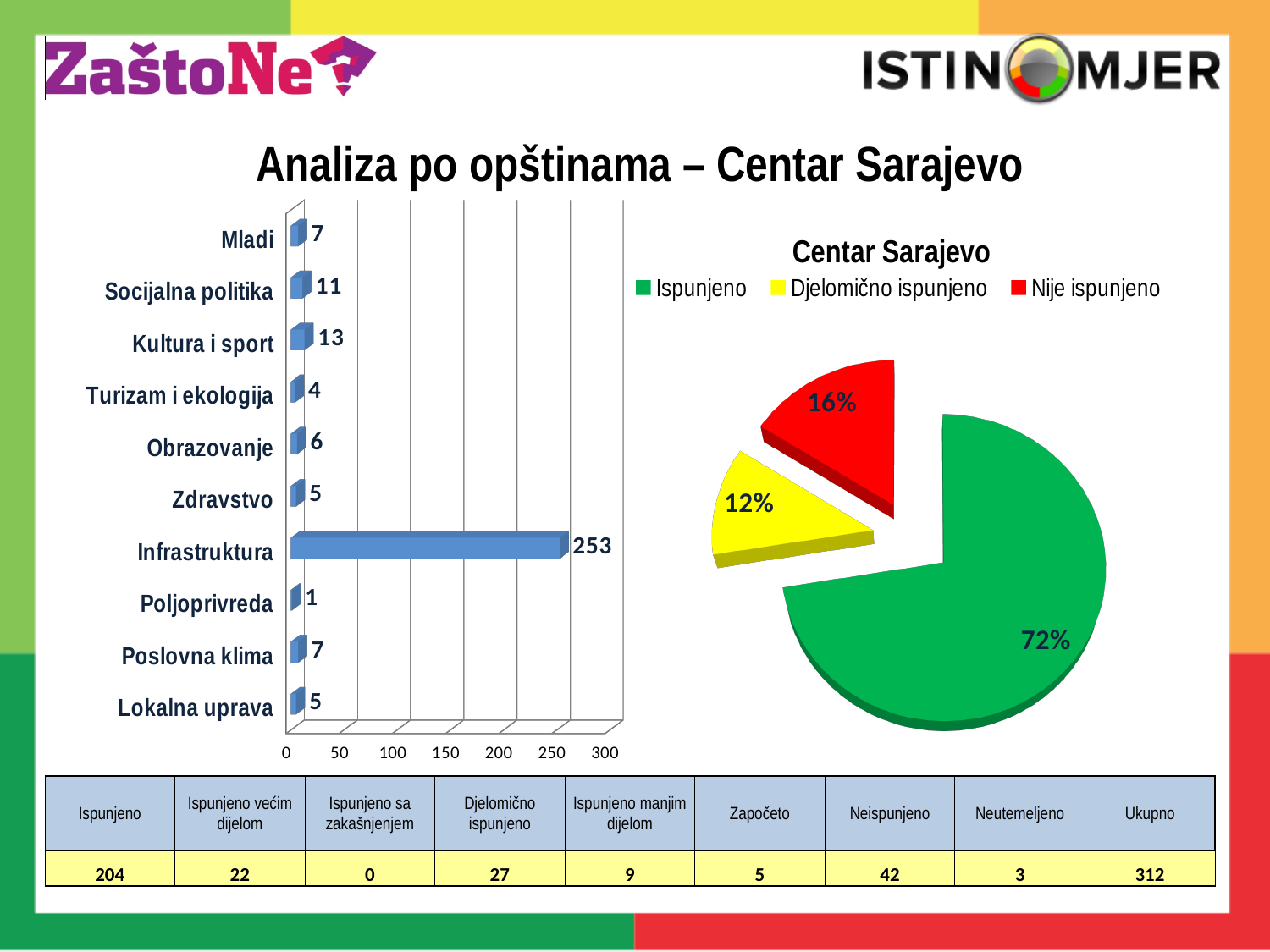
How many categories are shown in the bar chart on the left? 10 In the bar chart on the left, which is larger: the value for Obrazovanje or the value for Turizam i ekologija? Obrazovanje In the bar chart on the left, which category has the lowest value? Poljoprivreda In the pie chart titled Centar Sarajevo, what share does Ispunjeno have? 72% In the bar chart on the left, what is the value for Kultura i sport? 13 In the bar chart on the left, what is the difference between the values for Socijalna politika and Mladi? 4 In the bar chart on the left, is the value for Infrastruktura greater or less than 250? greater In the bar chart on the left, which category has the highest value? Infrastruktura How many series does the legend of the pie chart titled Centar Sarajevo list? 3 In the pie chart titled Centar Sarajevo, which slice is the smallest? Djelomično ispunjeno In the bar chart on the left, what is the value for Infrastruktura? 253 What kind of chart is the chart on the left of the slide? bar chart